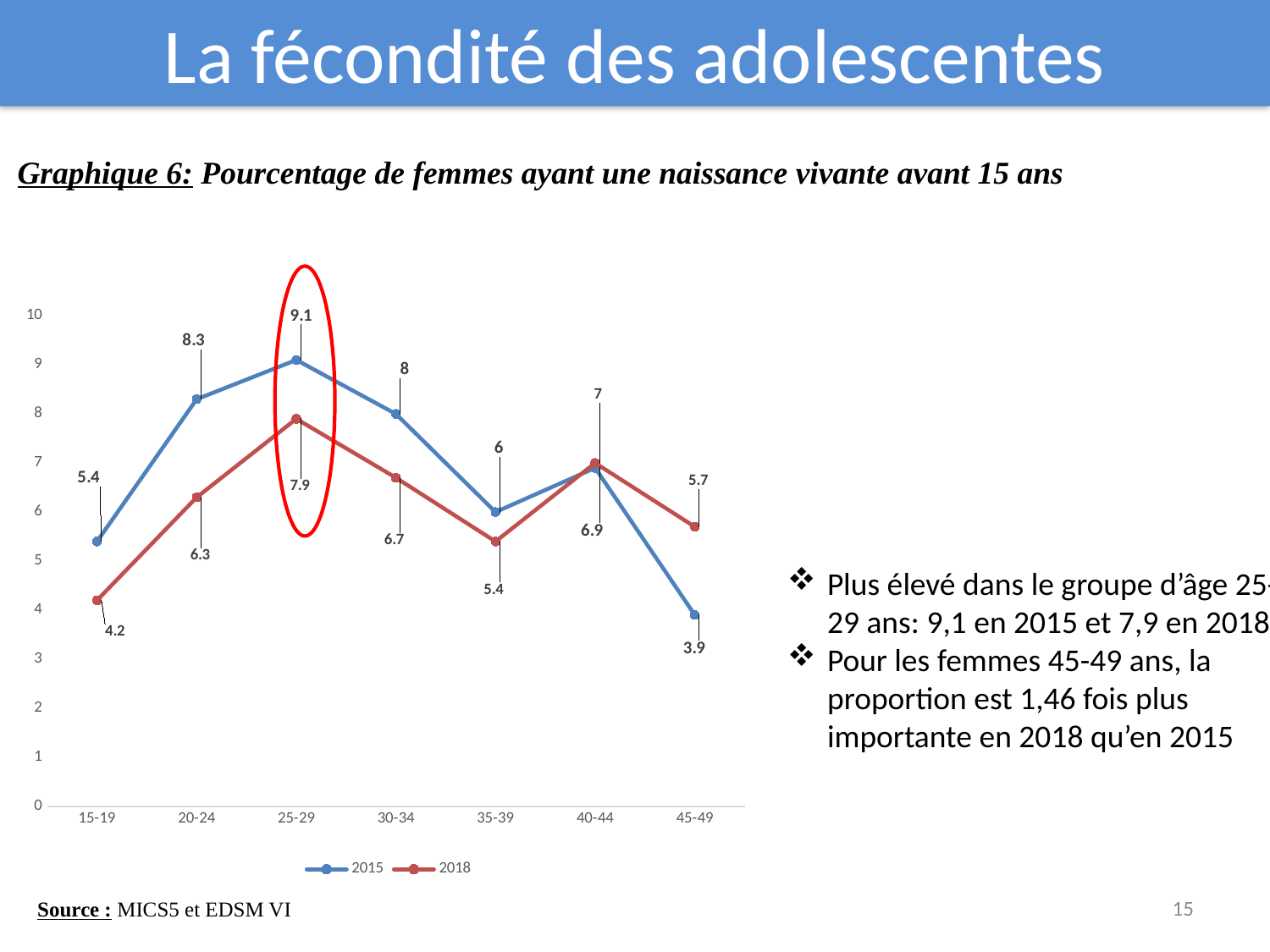
Which age group has the lowest value in the 2018 series? 15-19 How many age groups are shown on the x axis? 7 What is the value for the 25-29 age group in the 2015 series? 9.1 What is the difference between the 2015 and 2018 values for the 20-24 age group? 2 Which age group has the highest value in the 2015 series? 25-29 Which age group is circled in red on the chart? 25-29 How many series does the legend list? 2 What type of chart is shown on the slide? line chart Do the 2015 values rise or fall from the 40-44 age group to the 45-49 age group? fall What is the value for the 25-29 age group in the 2018 series? 7.9 For the 45-49 age group, which series has the larger value, 2015 or 2018? 2018 What is the value for the 45-49 age group in the 2015 series? 3.9